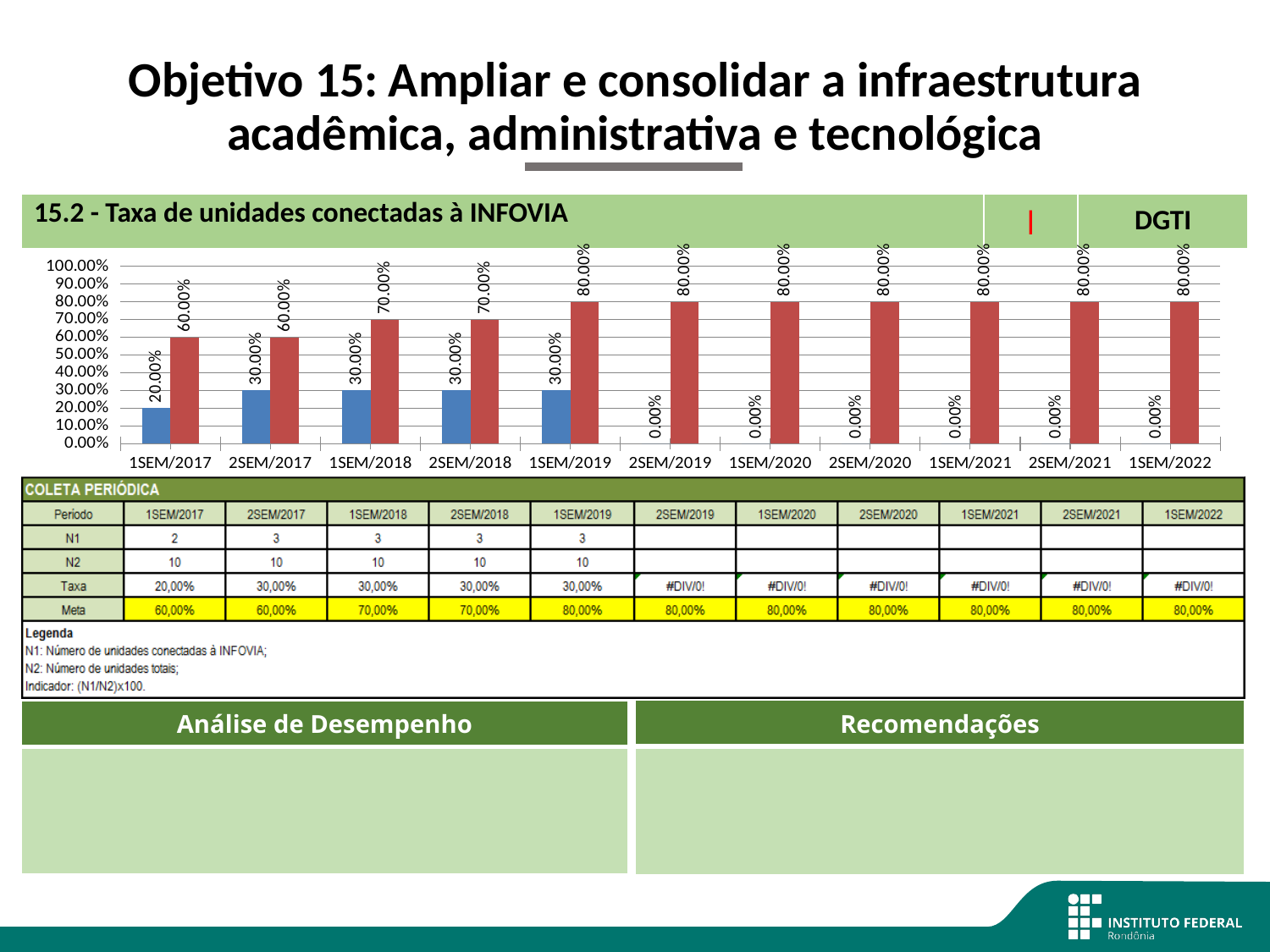
What is the difference between the red bar and the blue bar for 1SEM/2017? 40.00% What is the value of the red bar for 1SEM/2018? 70.00% What kind of chart is shown on the slide? bar chart What is the title of the chart? 15.2 - Taxa de unidades conectadas à INFOVIA What is the value of the blue bar for 2SEM/2019? 0.00% What is the value of the blue bar for 1SEM/2017? 20.00% How many periods are shown on the x axis of the chart? 11 Which period has the lowest red bar value? 1SEM/2017 and 2SEM/2017 (60.00%) Do the red bar values rise or fall from 1SEM/2017 to 1SEM/2019? rise What is the difference between the red bar and the blue bar for 1SEM/2019? 50.00% Which is larger for 2SEM/2018, the blue bar or the red bar? the red bar What is the value of the red bar for 1SEM/2022? 80.00%